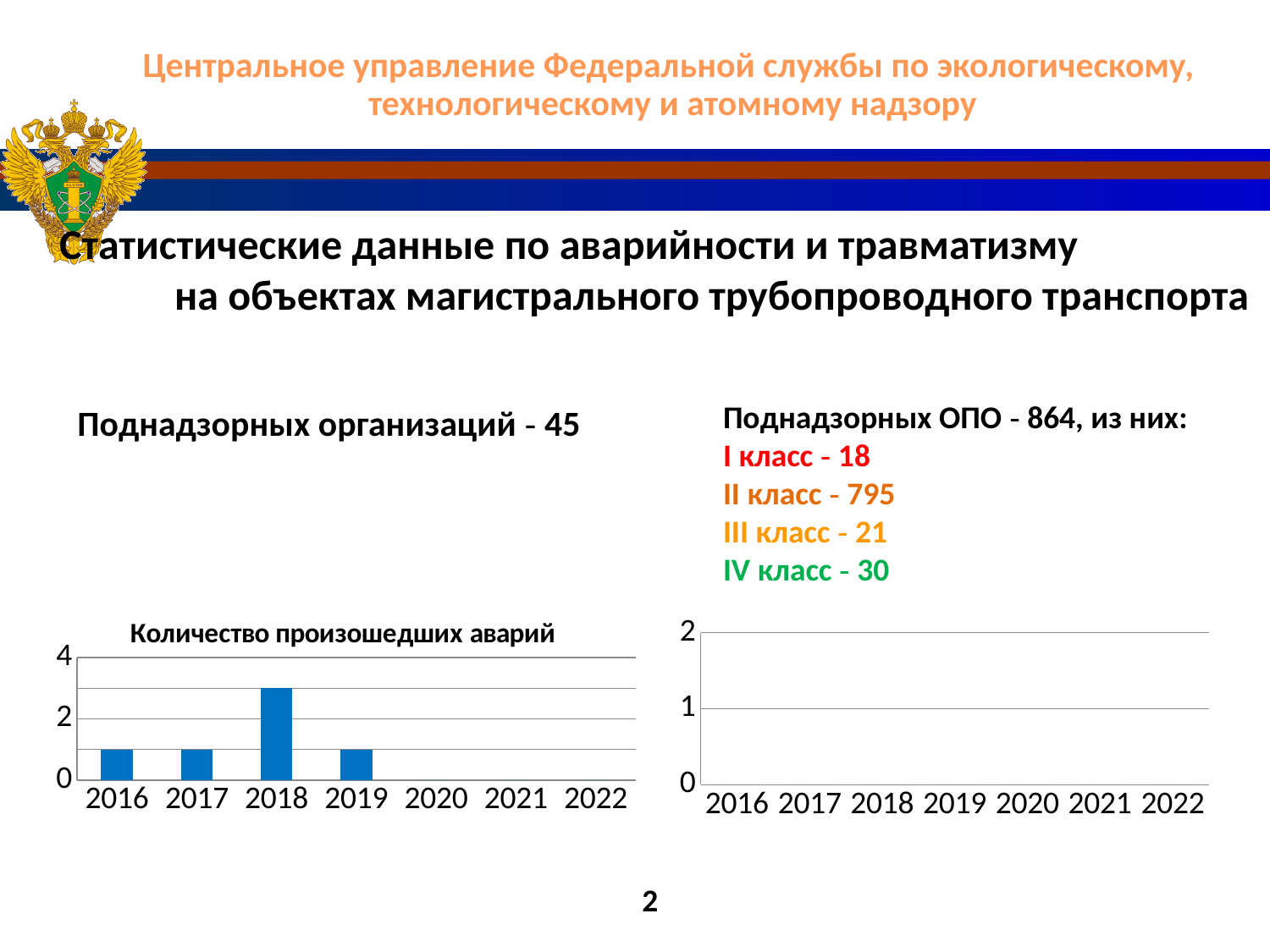
On the chart titled "Количество произошедших аварий", do the values rise or fall from 2018 to 2022? fall On the chart titled "Количество произошедших аварий", is the value for 2018 greater or less than 2? greater On the chart titled "Количество произошедших аварий", is the value for 2019 greater or less than 2? less On the chart titled "Количество произошедших аварий", is the value for 2016 greater or less than 2? less On the chart on the right side of the slide, what is the highest value labelled on the y axis? 2 On the chart titled "Количество произошедших аварий", which is larger, the value for 2018 or the value for 2017? 2018 On the chart on the right side of the slide, how many years are shown on the x axis? 7 On the chart titled "Количество произошедших аварий", how many years are shown on the x axis? 7 What kind of chart is the chart titled "Количество произошедших аварий"? bar chart On the chart titled "Количество произошедших аварий", what is the highest value labelled on the y axis? 4 On the chart titled "Количество произошедших аварий", what is the value for 2020? 0 On the chart titled "Количество произошедших аварий", which year has the highest value? 2018